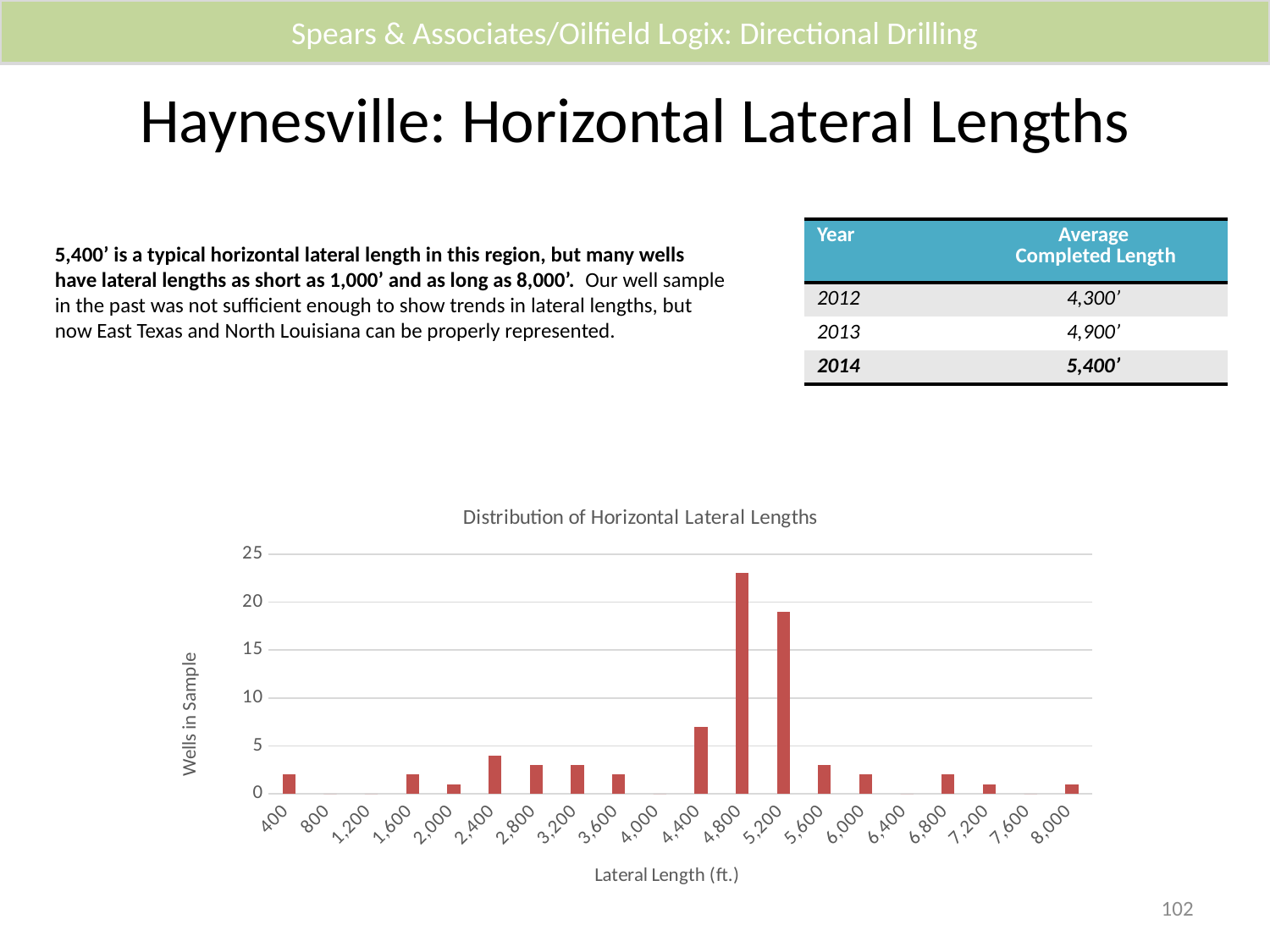
What is the title of the chart? Distribution of Horizontal Lateral Lengths Which has more wells in the sample, the 4,400 or the 2,400 lateral length? 4,400 What kind of chart is shown on the slide? bar chart Is the number of wells for the 4,400 lateral length greater or less than 5? greater Which lateral length has the highest number of wells in the sample? 4,800 Which has more wells in the sample, the 4,800 or the 5,200 lateral length? 4,800 Is the number of wells for the 4,800 lateral length greater or less than 20? greater Is the number of wells for the 5,200 lateral length greater or less than 15? greater What is the label of the vertical axis of the chart? Wells in Sample How many lateral length categories are labelled on the x axis of the chart? 20